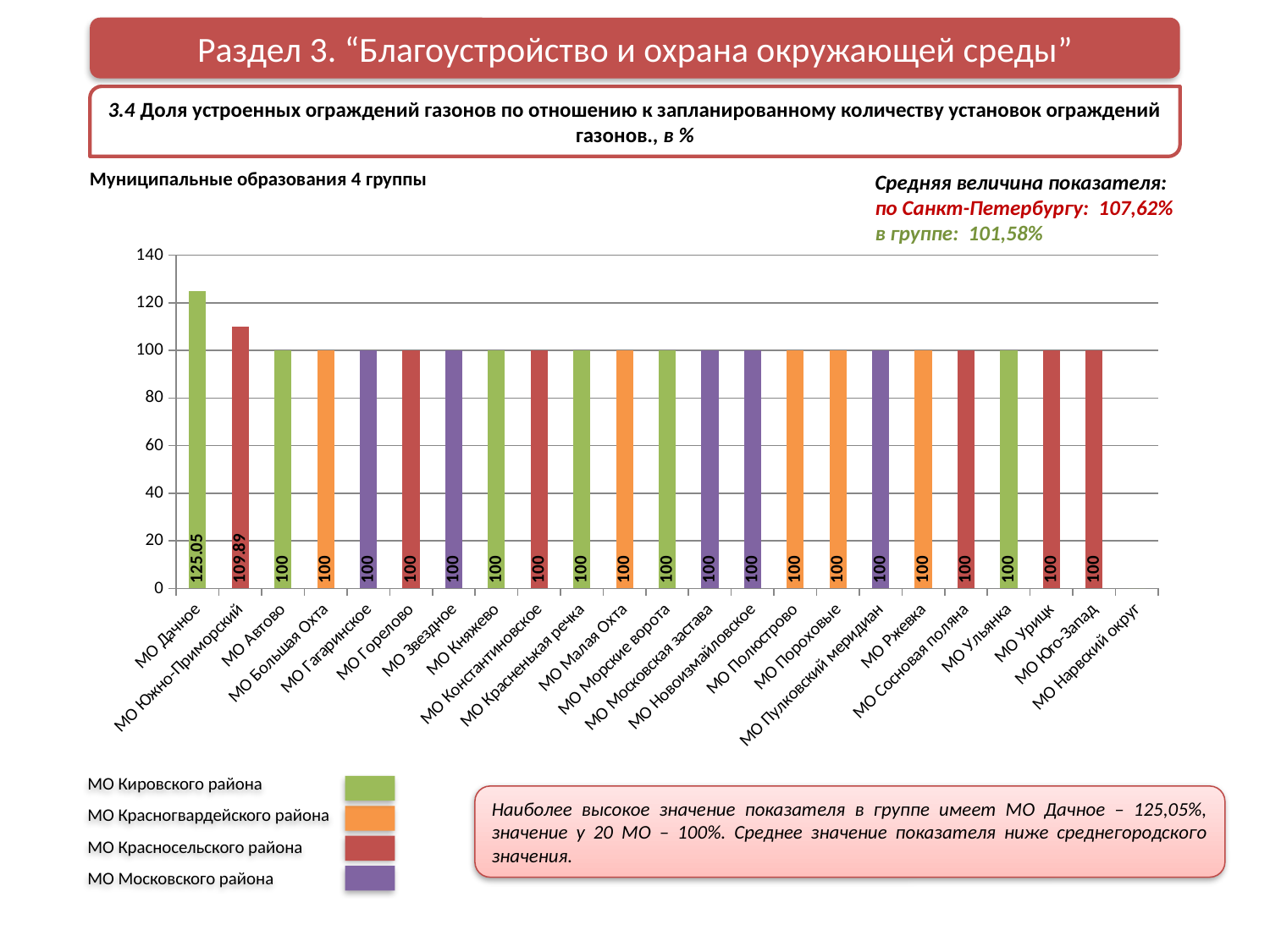
How many municipalities are labelled on the x axis of the chart? 23 Which is larger, the value for МО Дачное or the value for МО Южно-Приморский? МО Дачное What colour represents МО Московского района in the legend? purple What is the value for МО Южно-Приморский? 109.89 What is the value for МО Дачное? 125.05 What kind of chart is shown on the slide? bar chart How many entries does the colour legend below the chart list? 4 What is the difference between the values for МО Дачное and МО Южно-Приморский? 15.16 Which municipality has the highest value on the chart? МО Дачное Is the value for МО Дачное greater or less than 120? greater What is the value for МО Ульянка? 100 What is the difference between the values for МО Южно-Приморский and МО Автово? 9.89